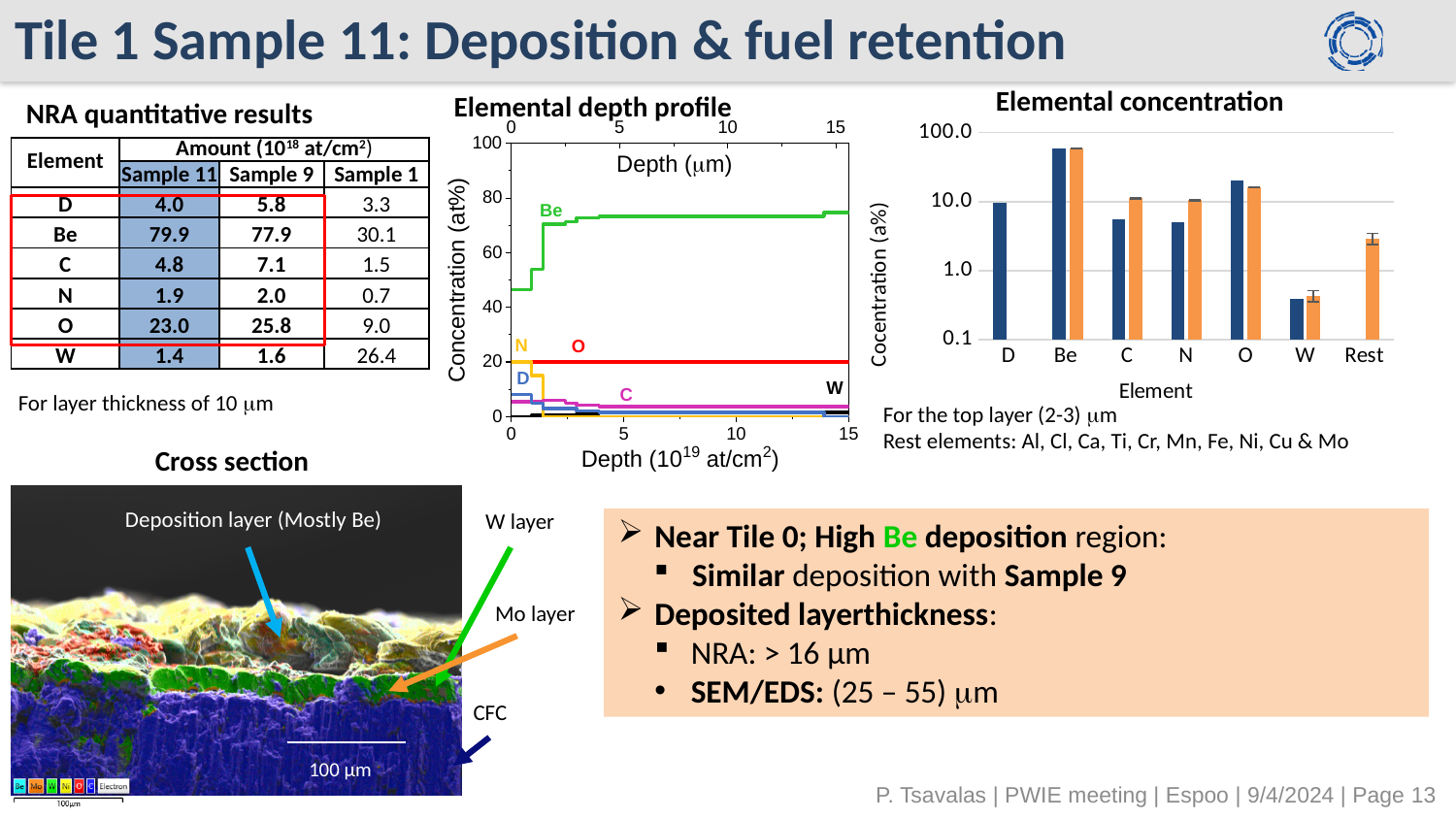
In the 'Elemental concentration' chart, how many elements are shown on the x axis? 7 In the 'Elemental concentration' chart, which element has the highest concentration? Be What type of chart is the 'Elemental depth profile' chart? line chart In the 'Elemental concentration' chart, is the concentration for W greater or less than 1.0? less What type of chart is the 'Elemental concentration' chart? bar chart What is the y-axis label of the 'Elemental concentration' chart? Cocentration (a%) In the 'Elemental depth profile' chart, does the Be concentration rise or fall as depth increases from 0 to 5? rise In the 'Elemental concentration' chart, is the concentration for Be greater or less than 10.0? greater In the 'Elemental concentration' chart, which has the larger concentration, Be or C? Be In the 'Elemental depth profile' chart, which element has the highest concentration across the depth range? Be In the 'Elemental concentration' chart, is the concentration for O greater or less than 10.0? greater In the 'Elemental concentration' chart, which element has the lowest concentration? W